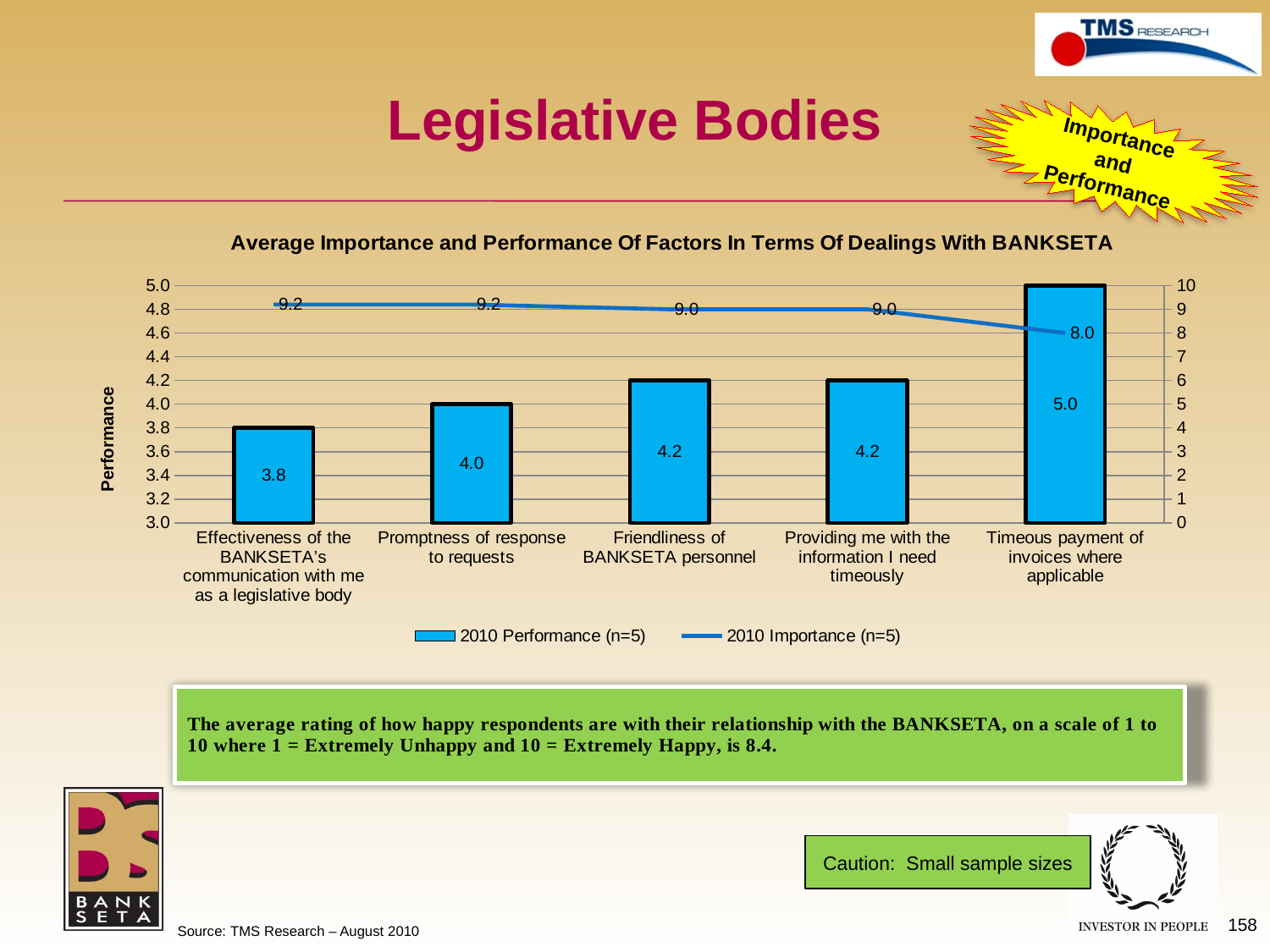
What is the difference between the 2010 Importance and 2010 Performance values for "Promptness of response to requests"? 5.2 What is the title of the chart? Average Importance and Performance Of Factors In Terms Of Dealings With BANKSETA What is the 2010 Importance value for "Friendliness of BANKSETA personnel"? 9.0 Which is larger: the 2010 Performance value for "Promptness of response to requests" or for "Friendliness of BANKSETA personnel"? Friendliness of BANKSETA personnel Does the 2010 Importance line rise or fall from left to right across the factors? Fall What is the 2010 Performance value for "Effectiveness of the BANKSETA's communication with me as a legislative body"? 3.8 How many series does the chart legend list? 2 How many factors (categories) are shown on the x axis of the chart? 5 Which factor has the lowest 2010 Importance value? Timeous payment of invoices where applicable What kind of chart is used to show the 2010 Performance series? Bar chart Which factor has the highest 2010 Performance value? Timeous payment of invoices where applicable What is the 2010 Performance value for "Timeous payment of invoices where applicable"? 5.0